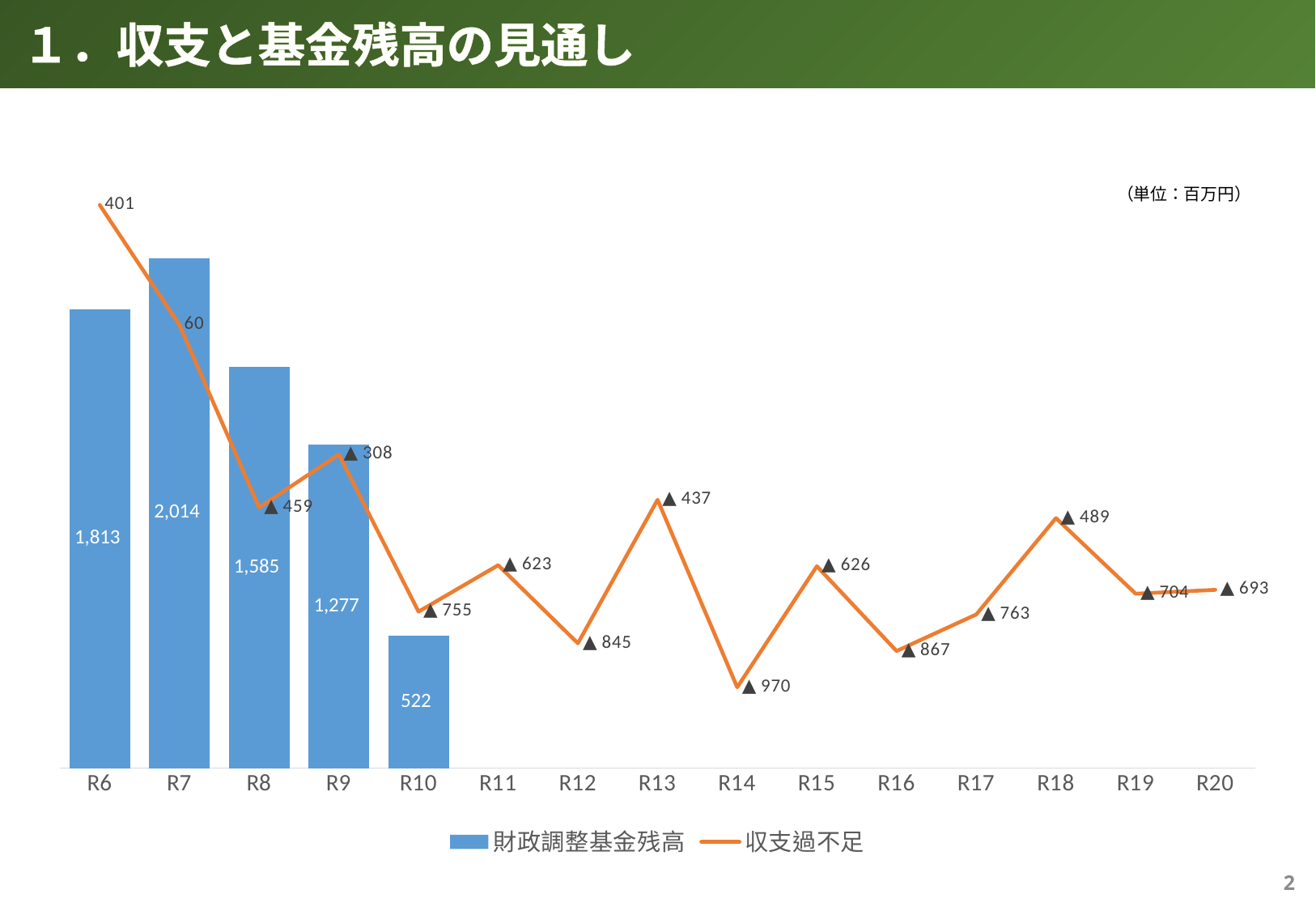
Which year has the lowest 財政調整基金残高 bar? R10 How many years are shown on the x axis? 15 What is the value of 財政調整基金残高 for R10? 522 Do the 財政調整基金残高 bars rise or fall from R7 to R10? Fall Which year has the highest 財政調整基金残高 bar? R7 What is the value of 財政調整基金残高 for R6? 1,813 What is the 収支過不足 value shown for R6? 401 What kind of chart is this? Combination bar and line chart What is the difference between the 財政調整基金残高 values for R7 and R6? 201 Which is larger, the 財政調整基金残高 for R8 or for R9? R8 What is the 収支過不足 value shown for R14? ▲ 970 How many series does the legend list? 2